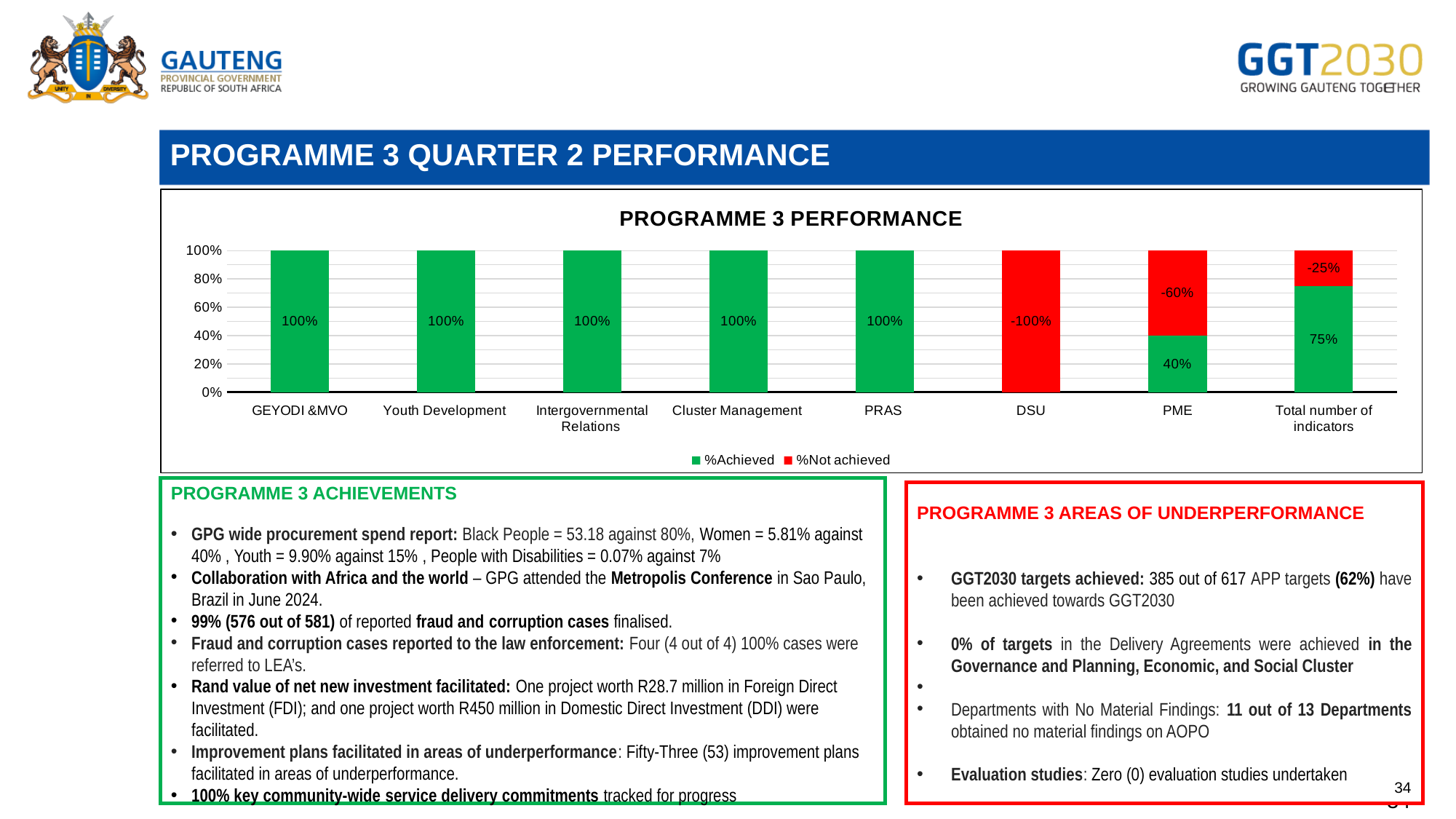
What is the %Achieved value for Cluster Management? 100% What is the %Not achieved value for PME? -60% What is the difference between the %Achieved value for PRAS and the %Achieved value for PME? 60% What is the %Achieved value for Total number of indicators? 75% What type of chart is shown on the slide? bar chart Which category has the lowest %Achieved value among those with a green segment? PME Which is larger, the %Achieved value for PME or for Total number of indicators? Total number of indicators What is the title of the chart? PROGRAMME 3 PERFORMANCE What is the %Not achieved value for DSU? -100% How many series does the chart legend list? 2 What is the %Achieved value for PME? 40% How many categories are shown on the x axis of the chart? 8